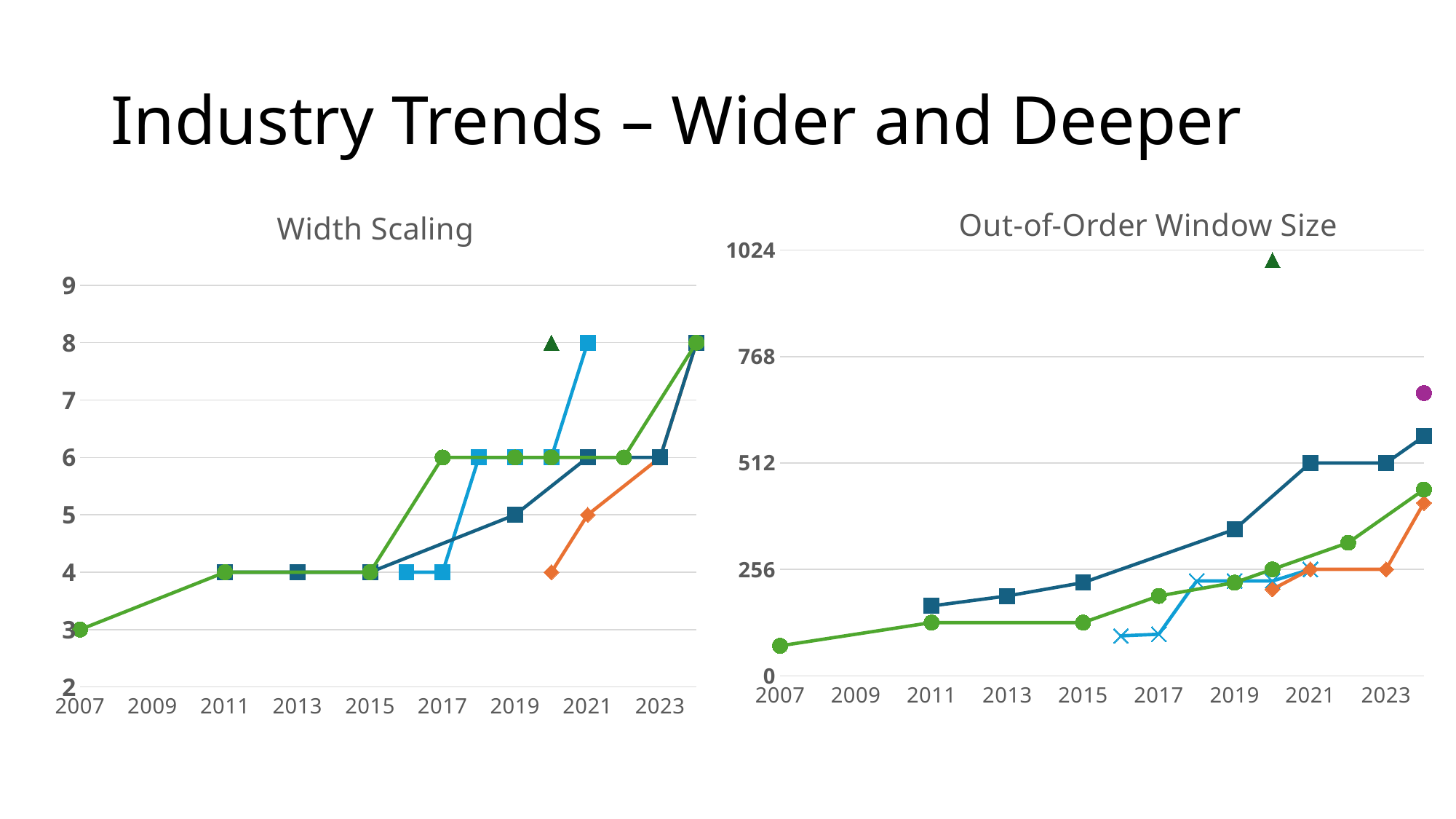
What kind of chart is the Width Scaling chart? line chart What is the title of the chart on the left of the slide? Width Scaling What kind of chart is the Out-of-Order Window Size chart? line chart In the Out-of-Order Window Size chart, is the value of the purple circle point at 2024 greater or less than 512? greater In the Width Scaling chart, what value does the light blue square series reach at 2021? 8 In the Out-of-Order Window Size chart, is the value of the dark green triangle point at 2020 greater or less than 768? greater In the Width Scaling chart, do the values generally rise or fall from 2007 to 2024? rise In the Width Scaling chart, what is the value of the orange diamond point at 2021? 5 In the Width Scaling chart, what is the value of the green circle series at 2007? 3 In the Out-of-Order Window Size chart, is the value of the green circle series at 2007 greater or less than 256? less In the Width Scaling chart, what is the value of the dark green triangle point at 2020? 8 What is the title of the chart on the right of the slide? Out-of-Order Window Size